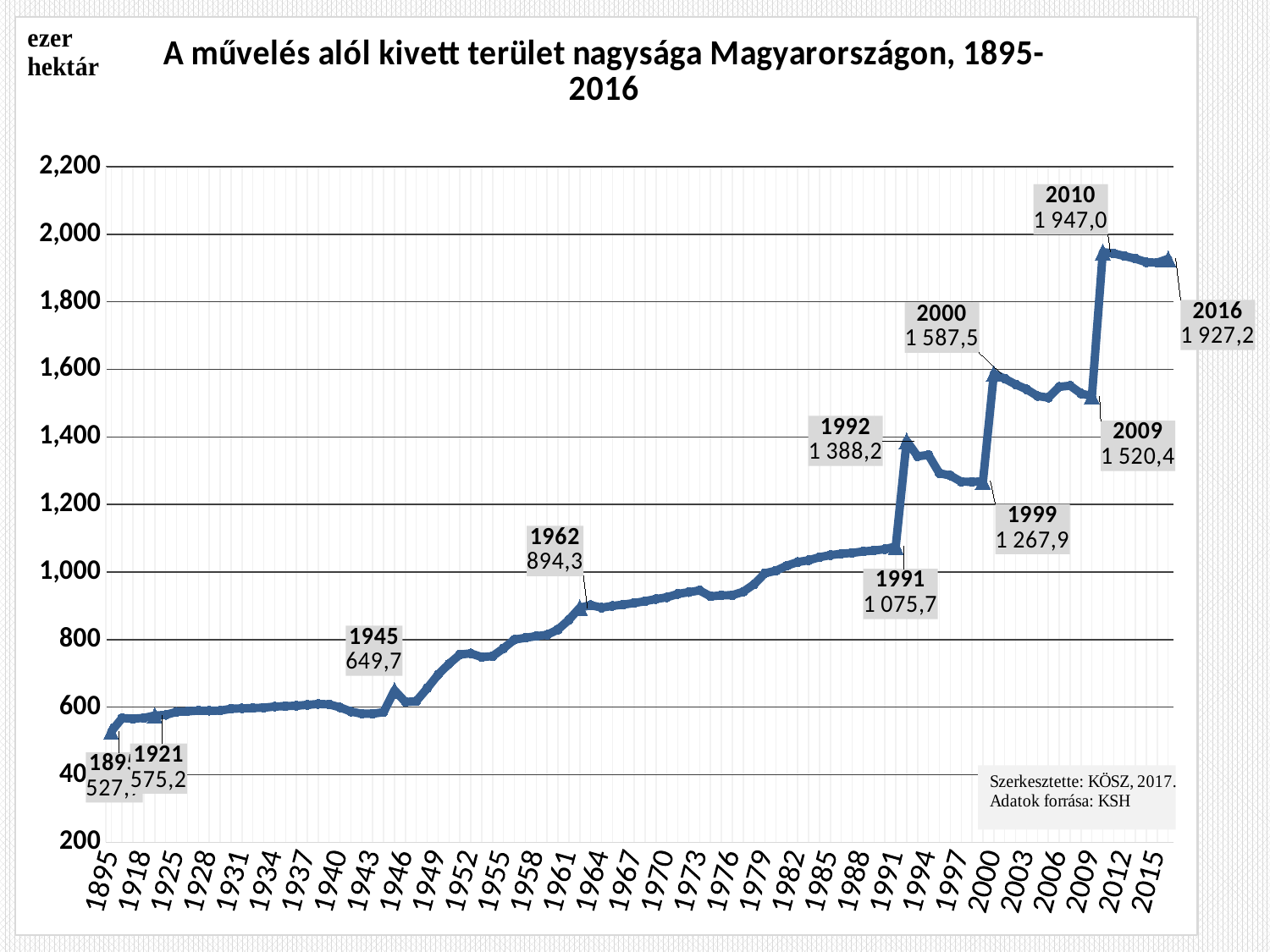
What is the value labelled for 2010? 1 947,0 What unit is shown at the top left of the chart? ezer hektár What is the value labelled for 1962? 894,3 What is the difference between the values labelled for 1992 and 1991? 312,5 What is the value labelled for 1945? 649,7 What kind of chart is shown on the slide? line chart What is the value labelled for 1991? 1 075,7 Which is larger, the value for 2000 or the value for 2009? 2000 Which labelled year has the highest value? 2010 Is the value for 1999 greater or less than 1,200? greater Does the value generally rise or fall from 1895 to 2016? rise What is the value labelled for 2016? 1 927,2